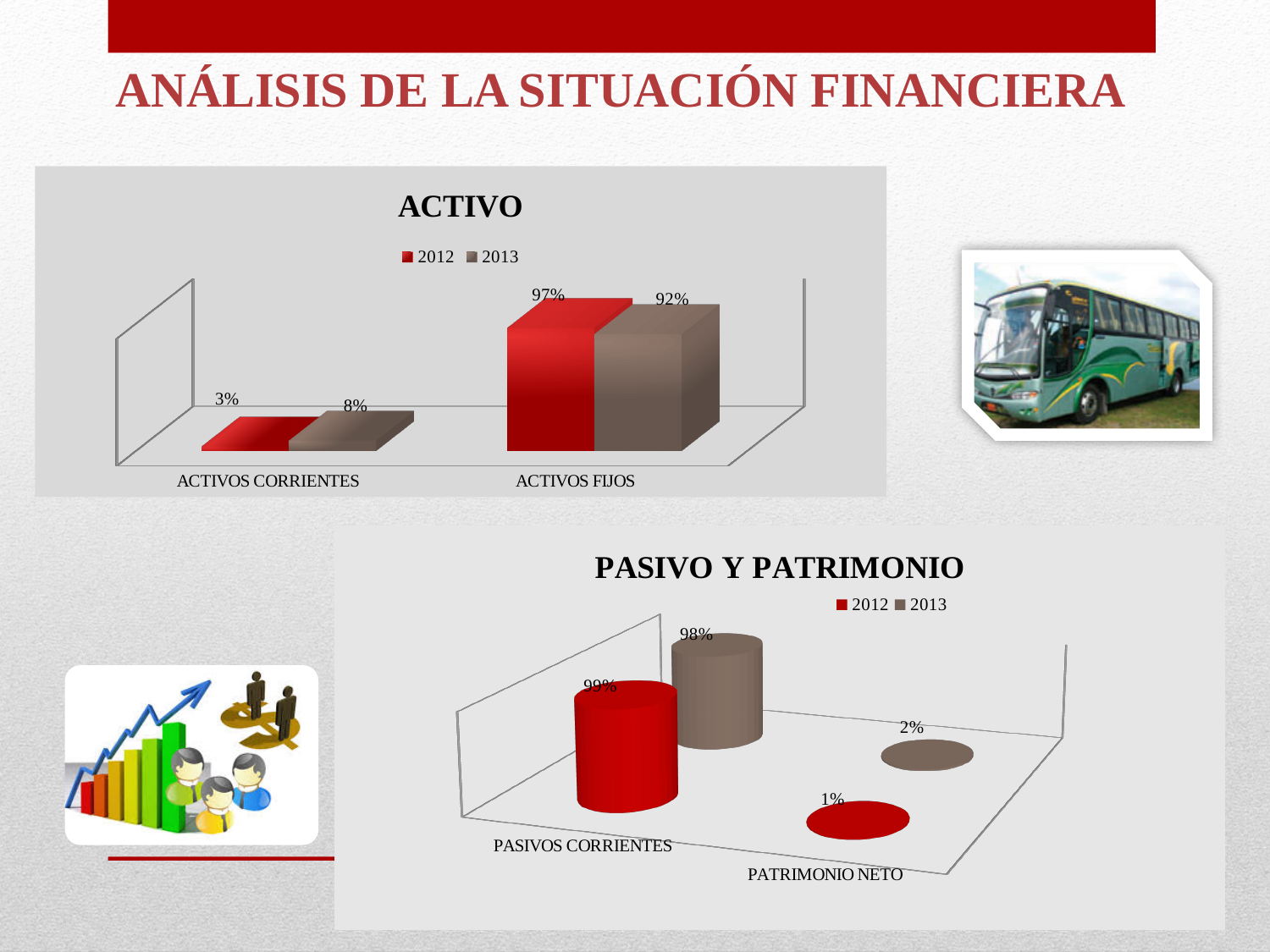
In the PASIVO Y PATRIMONIO chart, which category has the lowest value in 2012? PATRIMONIO NETO In the PASIVO Y PATRIMONIO chart, what is the value for PASIVOS CORRIENTES in 2012? 99% In the ACTIVO chart, which category has the highest value in 2012? ACTIVOS FIJOS What type of chart is the ACTIVO chart? bar chart In the PASIVO Y PATRIMONIO chart, what is the value for PATRIMONIO NETO in 2013? 2% In the ACTIVO chart, what is the value for ACTIVOS FIJOS in 2013? 92% In the ACTIVO chart, is the 2013 value for ACTIVOS CORRIENTES larger or smaller than the 2012 value? larger In the ACTIVO chart, how many series does the legend list? 2 In the PASIVO Y PATRIMONIO chart, what is the difference between the 2012 and 2013 values for PASIVOS CORRIENTES? 1% In the ACTIVO chart, what is the difference between the 2012 and 2013 values for ACTIVOS FIJOS? 5% In the ACTIVO chart, what is the value for ACTIVOS CORRIENTES in 2012? 3% How many categories are shown in the PASIVO Y PATRIMONIO chart? 2